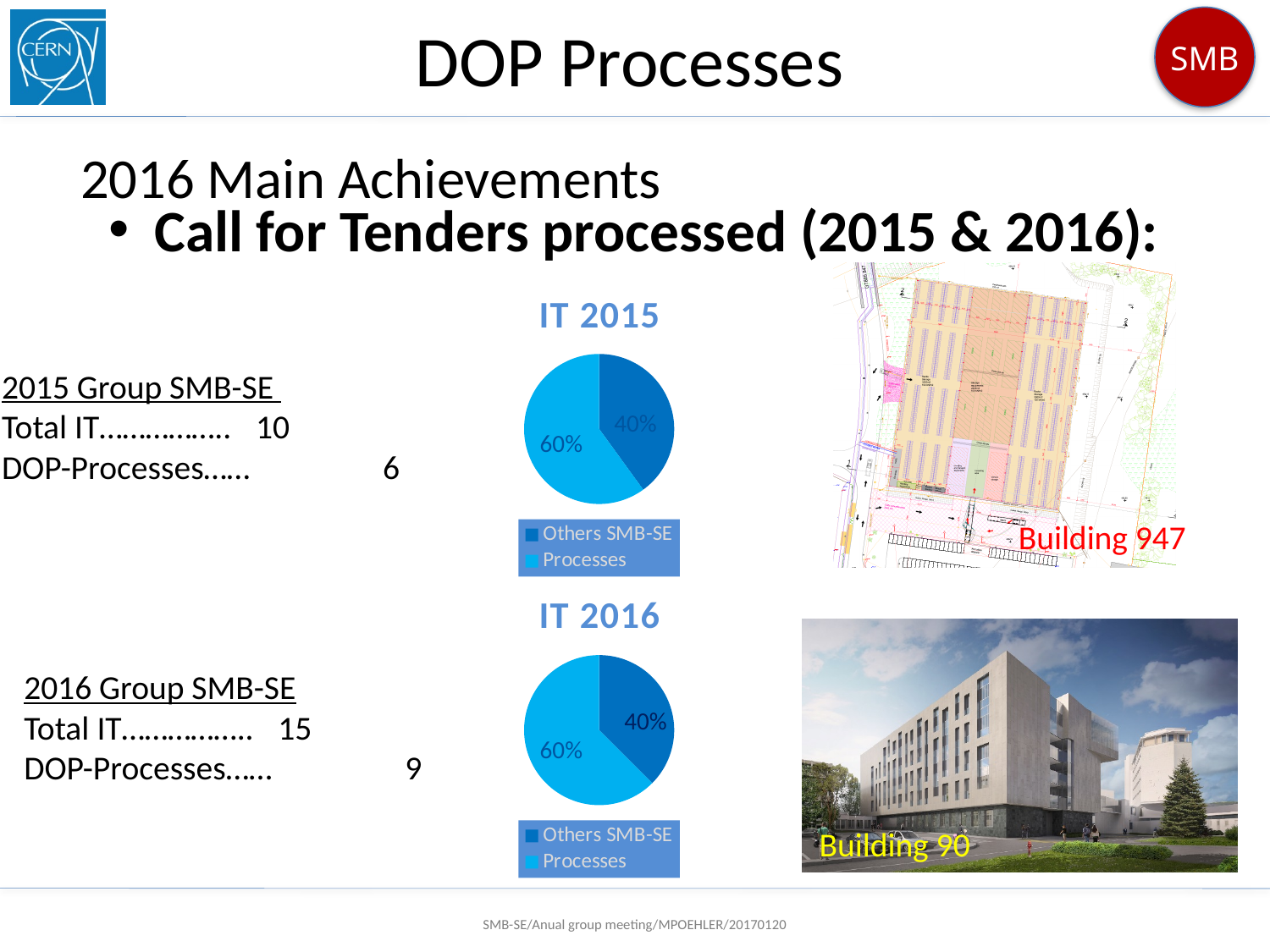
In the "IT 2016" chart, which slice is the smallest? Others SMB-SE In the "IT 2015" chart, what share does the Processes slice have? 60% How many entries does the legend of the "IT 2015" chart list? 2 What kind of chart is the "IT 2015" chart? pie chart In the "IT 2016" chart, what share does the Processes slice have? 60% What is the title of the lower pie chart on the slide? IT 2016 In the "IT 2015" chart, what share does the Others SMB-SE slice have? 40% In the "IT 2016" chart, which is larger, Processes or Others SMB-SE? Processes In the "IT 2015" chart, which slice is the largest? Processes In the "IT 2015" chart, what is the difference between the Processes share and the Others SMB-SE share? 20% How many slices does the "IT 2016" pie chart have? 2